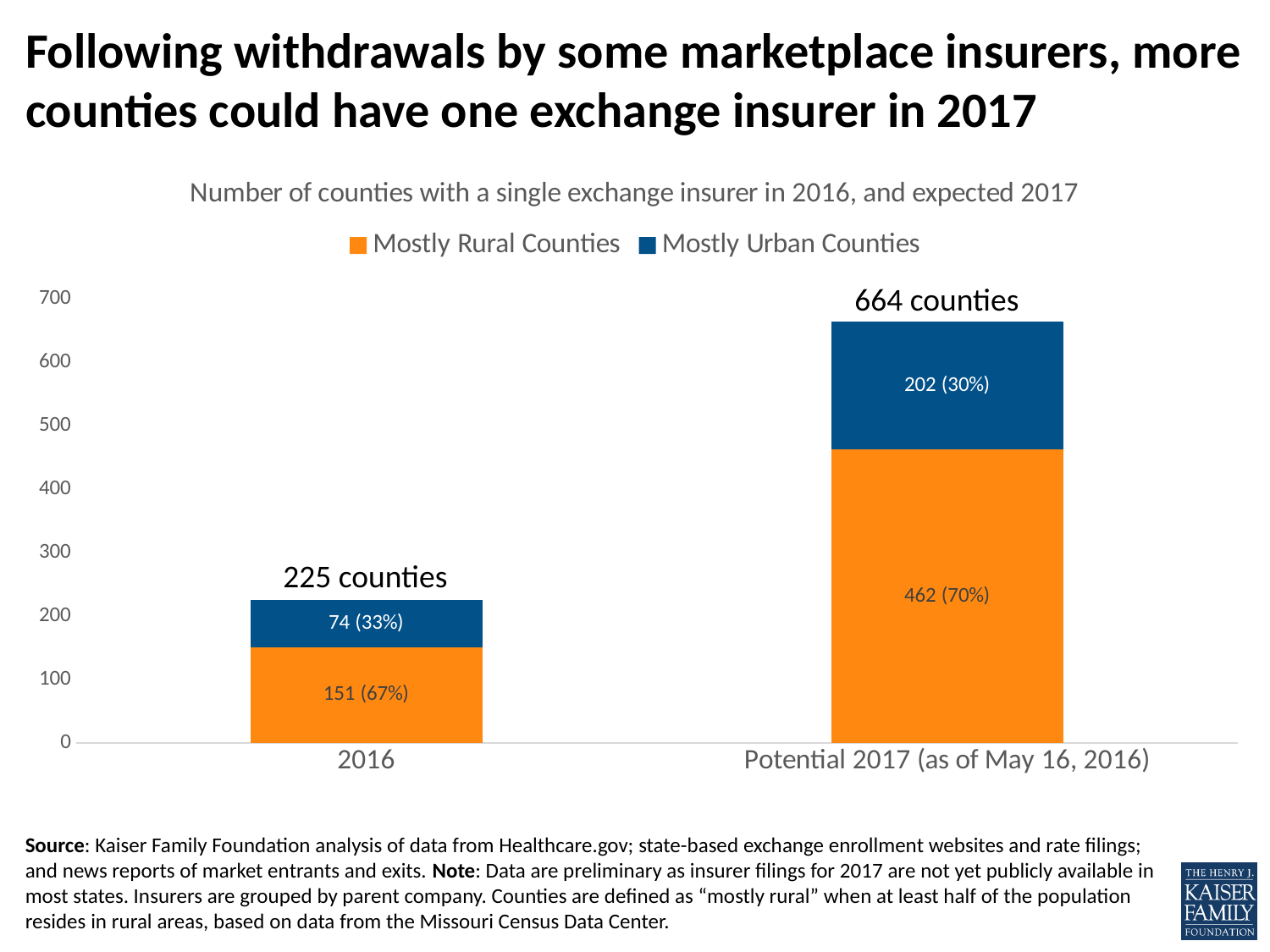
Which colour represents Mostly Urban Counties in the chart? Blue What is the total number of counties shown for the 2016 bar? 225 counties What is the difference between the Mostly Rural Counties values for Potential 2017 and 2016? 311 How many series does the legend list? 2 Which series has the larger value in 2016, Mostly Rural Counties or Mostly Urban Counties? Mostly Rural Counties Is the total for the 2016 bar greater or less than 300? less What is the value for Mostly Urban Counties in Potential 2017 (as of May 16, 2016)? 202 (30%) Which category has the higher total number of counties, 2016 or Potential 2017 (as of May 16, 2016)? Potential 2017 (as of May 16, 2016) What is the total number of counties shown for the Potential 2017 (as of May 16, 2016) bar? 664 counties What is the value for Mostly Rural Counties in 2016? 151 (67%) How many categories are shown on the x axis? 2 What kind of chart is shown on the slide? Stacked bar chart